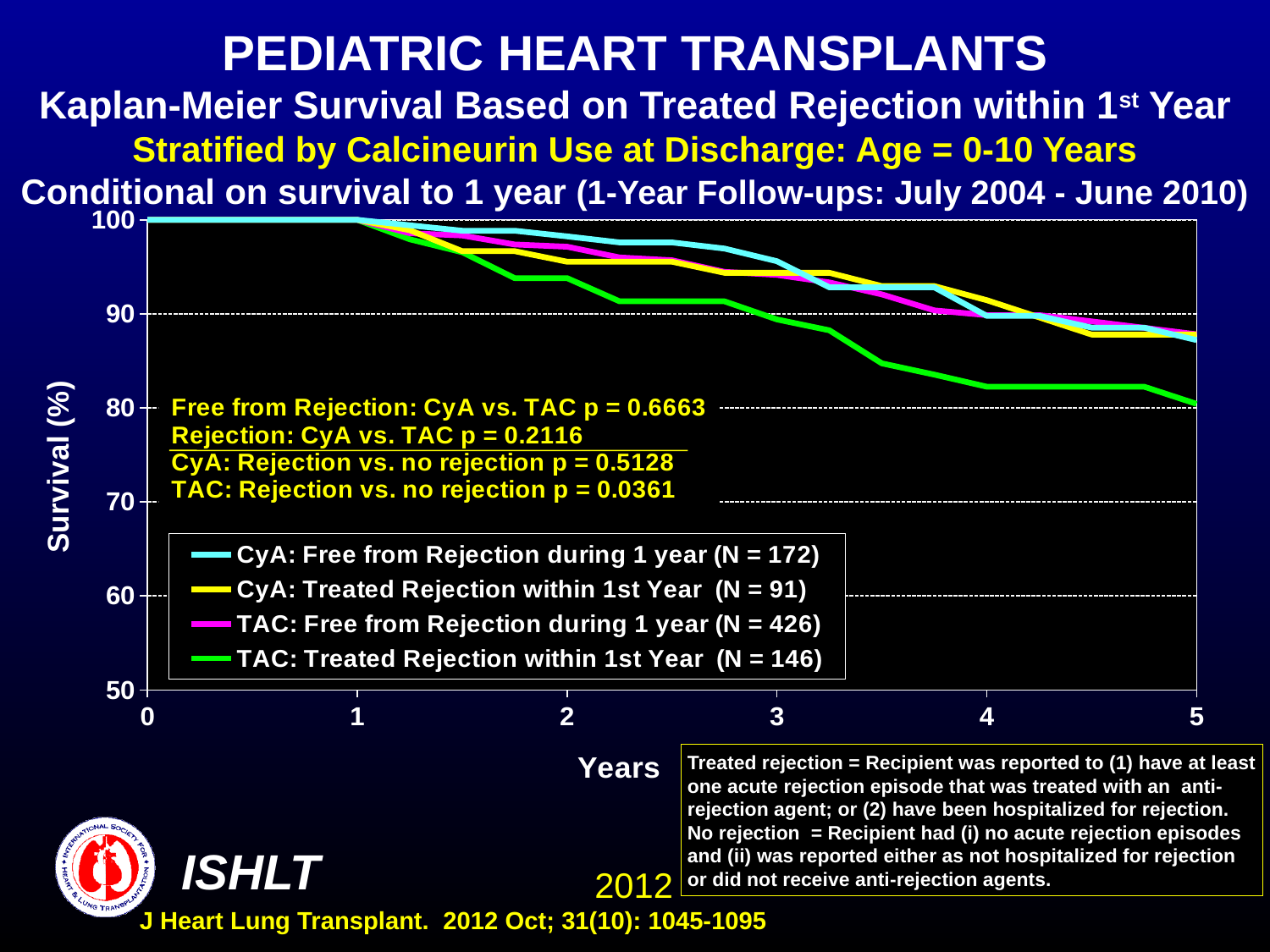
Do the survival curves rise or fall as years increase? fall What colour is the line for TAC: Treated Rejection within 1st Year? Green What is the N for the CyA: Free from Rejection during 1 year group? N = 172 What kind of chart is shown on the slide? Line chart Is the survival for CyA: Free from Rejection during 1 year at 5 years greater or less than 90? less What is the N for the TAC: Treated Rejection within 1st Year group? N = 146 How many series does the legend list? 4 What is the p-value for TAC: Rejection vs. no rejection? p = 0.0361 What is the N for the TAC: Free from Rejection during 1 year group? N = 426 Which group has the lowest survival at 4 years? TAC: Treated Rejection within 1st Year What is the N for the CyA: Treated Rejection within 1st Year group? N = 91